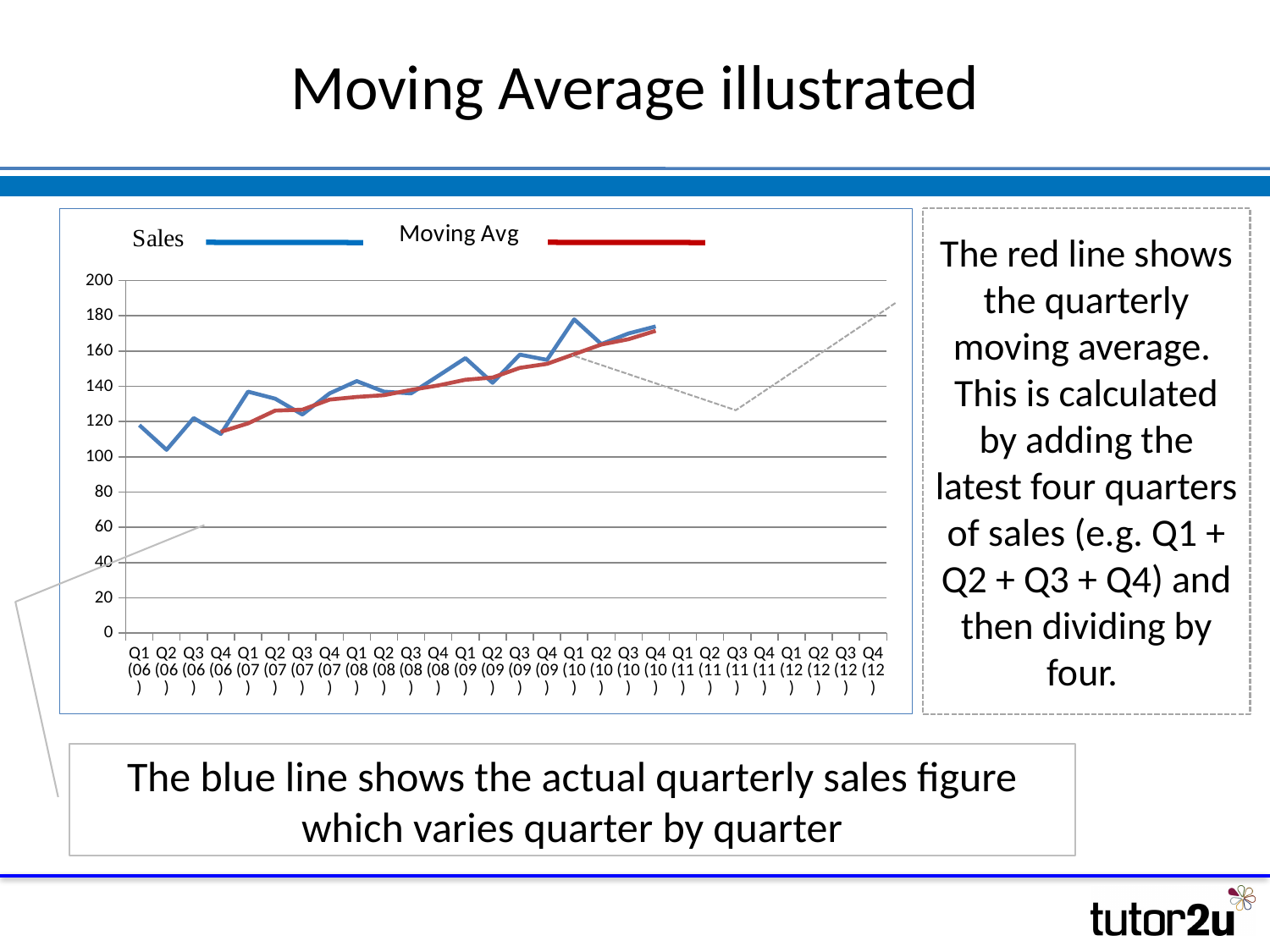
What are the two series named in the chart legend? Sales and Moving Avg Is the Moving Avg value for Q4 (10) greater or less than 160? greater Is the Sales value for Q1 (06) greater or less than 140? less Which is larger, the Sales value for Q1 (10) or the Sales value for Q2 (06)? Q1 (10) Is the Sales value for Q2 (06) greater or less than 120? less Does the Moving Avg line generally rise or fall from Q4 (06) to Q4 (10)? rise How many quarter categories are shown along the x axis of the chart? 28 Which quarter has the lowest Sales value in the chart? Q2 (06) How many series does the chart legend list? 2 What colour is the Moving Avg line in the chart? red What kind of chart is shown on the slide? line chart